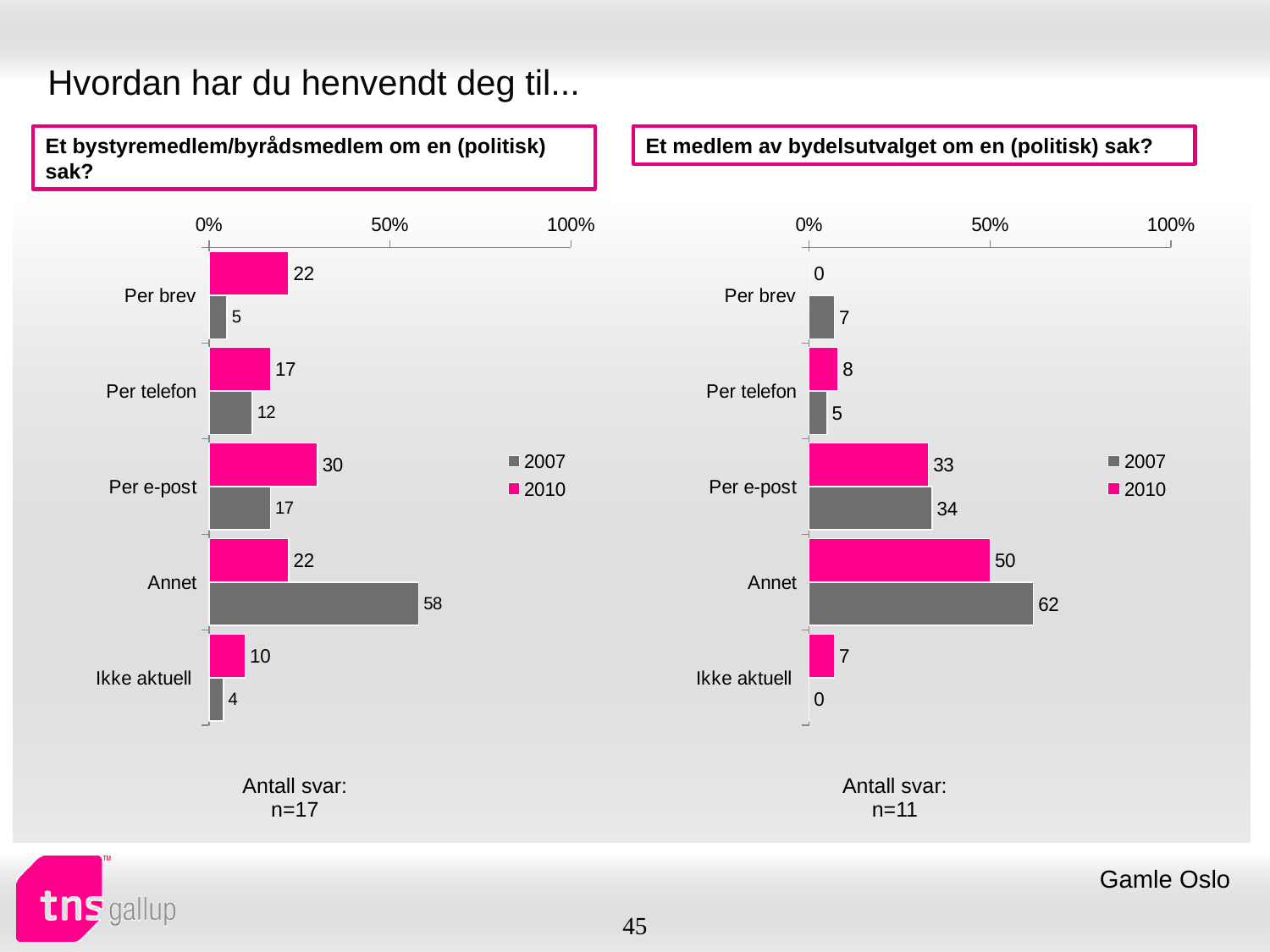
In the left chart (Et bystyremedlem/byrådsmedlem om en (politisk) sak?), which category has the lowest value for 2010? Ikke aktuell In the right chart (Et medlem av bydelsutvalget om en (politisk) sak?), what is the value for Per brev in 2010? 0 In the left chart (Et bystyremedlem/byrådsmedlem om en (politisk) sak?), what is the value for Per e-post in 2010? 30 In the right chart (Et medlem av bydelsutvalget om en (politisk) sak?), what is the difference between the 2010 and 2007 values for Per telefon? 3 In the left chart (Et bystyremedlem/byrådsmedlem om en (politisk) sak?), what is the difference between the 2007 and 2010 values for Annet? 36 How many series does the legend of the right chart (Et medlem av bydelsutvalget om en (politisk) sak?) list? 2 In the right chart (Et medlem av bydelsutvalget om en (politisk) sak?), what is the value for Annet in 2007? 62 In the left chart (Et bystyremedlem/byrådsmedlem om en (politisk) sak?), which category has the highest value for 2007? Annet What type of chart is the left chart (Et bystyremedlem/byrådsmedlem om en (politisk) sak?)? Bar chart In the left chart (Et bystyremedlem/byrådsmedlem om en (politisk) sak?), how many categories are shown? 5 In the left chart (Et bystyremedlem/byrådsmedlem om en (politisk) sak?), what is the value for Annet in 2007? 58 In the right chart (Et medlem av bydelsutvalget om en (politisk) sak?), which is larger for Annet: the 2007 value or the 2010 value? 2007